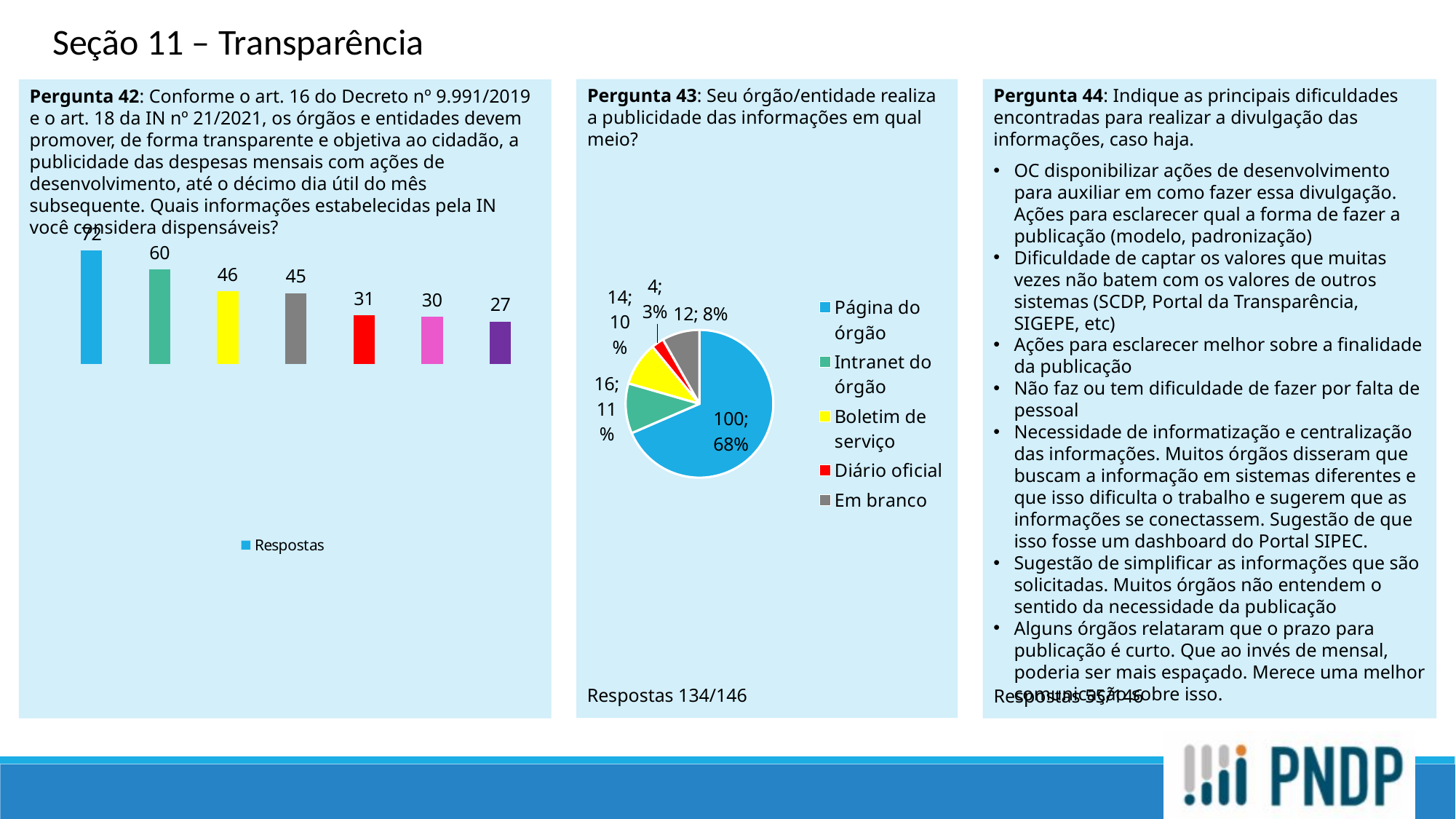
In the Pergunta 42 bar chart, what is the difference between the first bar (72) and the second bar (60)? 12 In the Pergunta 42 bar chart, what series name does the legend show? Respostas In the Pergunta 42 bar chart, do the values rise or fall from left to right? fall In the Pergunta 42 bar chart, what is the value of the yellow bar? 46 What kind of chart is shown under Pergunta 43? pie chart In the Pergunta 43 pie chart, which category has the smallest slice? Diário oficial What kind of chart is shown under Pergunta 42? bar chart In the Pergunta 42 bar chart, how many bars are plotted? 7 In the Pergunta 42 bar chart, what is the highest value shown? 72 In the Pergunta 42 bar chart, what is the lowest value shown? 27 In the Pergunta 43 pie chart, what share of the pie is 'Intranet do órgão'? 11% In the Pergunta 43 pie chart, how many responses are for 'Página do órgão'? 100